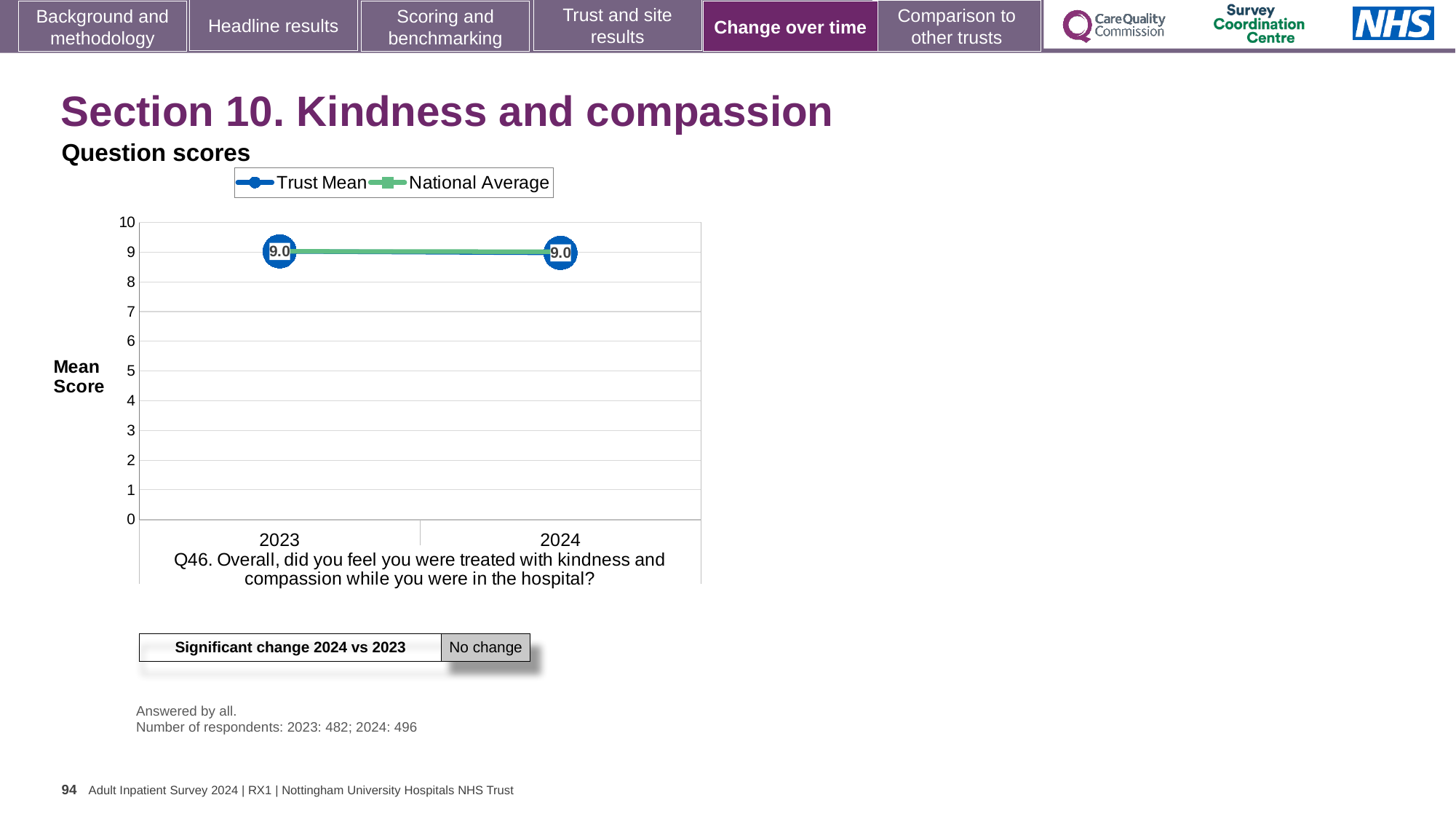
What is the difference between the Trust Mean scores for 2024 and 2023? 0.0 Does the Trust Mean rise, fall or stay the same from 2023 to 2024? stays the same What is the Trust Mean score for 2023? 9.0 What kind of chart is shown? line chart What is the Trust Mean score for 2024? 9.0 What is the y-axis label of the chart? Mean Score How many years are plotted on the x axis? 2 Which series is shown in green in the legend? National Average Is the Trust Mean for 2024 greater or less than 5? greater Is the National Average for 2023 greater or less than 8? greater What is the maximum value shown on the y axis? 10 How many series does the legend list? 2